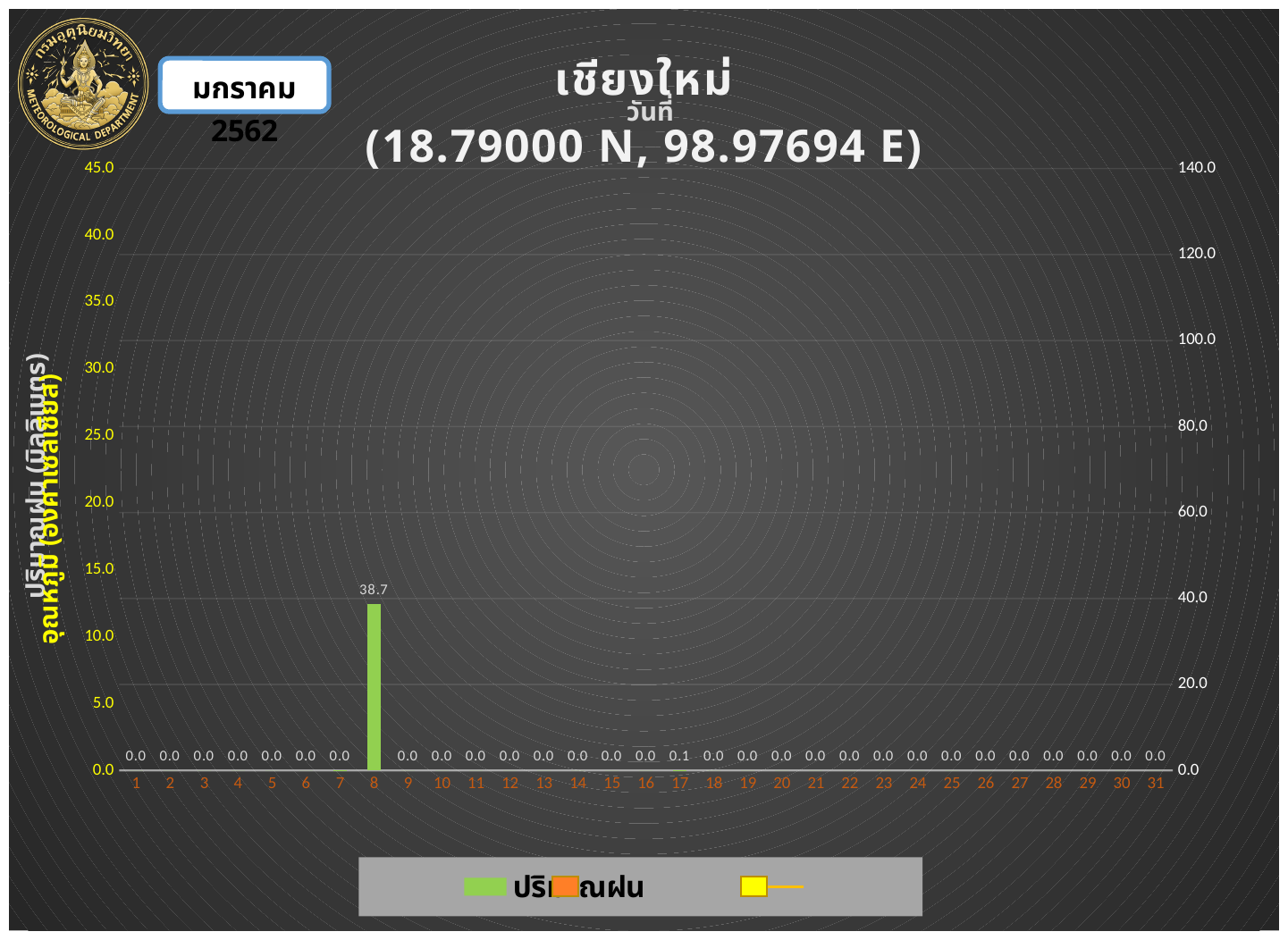
What is the difference between the rainfall values for day 8 and day 17? 38.6 What kind of chart is used to show the rainfall values? bar chart How many days are shown on the x axis? 31 Which day has the larger rainfall value, day 8 or day 17? 8 What is the rainfall value shown for day 17? 0.1 What is the highest tick value on the left-hand axis? 45.0 What is the highest tick value on the right-hand axis? 140.0 What is the rainfall value shown for day 1? 0.0 What is the rainfall value shown for day 8? 38.7 What is the rainfall value shown for day 31? 0.0 Is the rainfall value for day 8 greater or less than 20.0 on the right axis? greater Which day has the highest rainfall value? 8